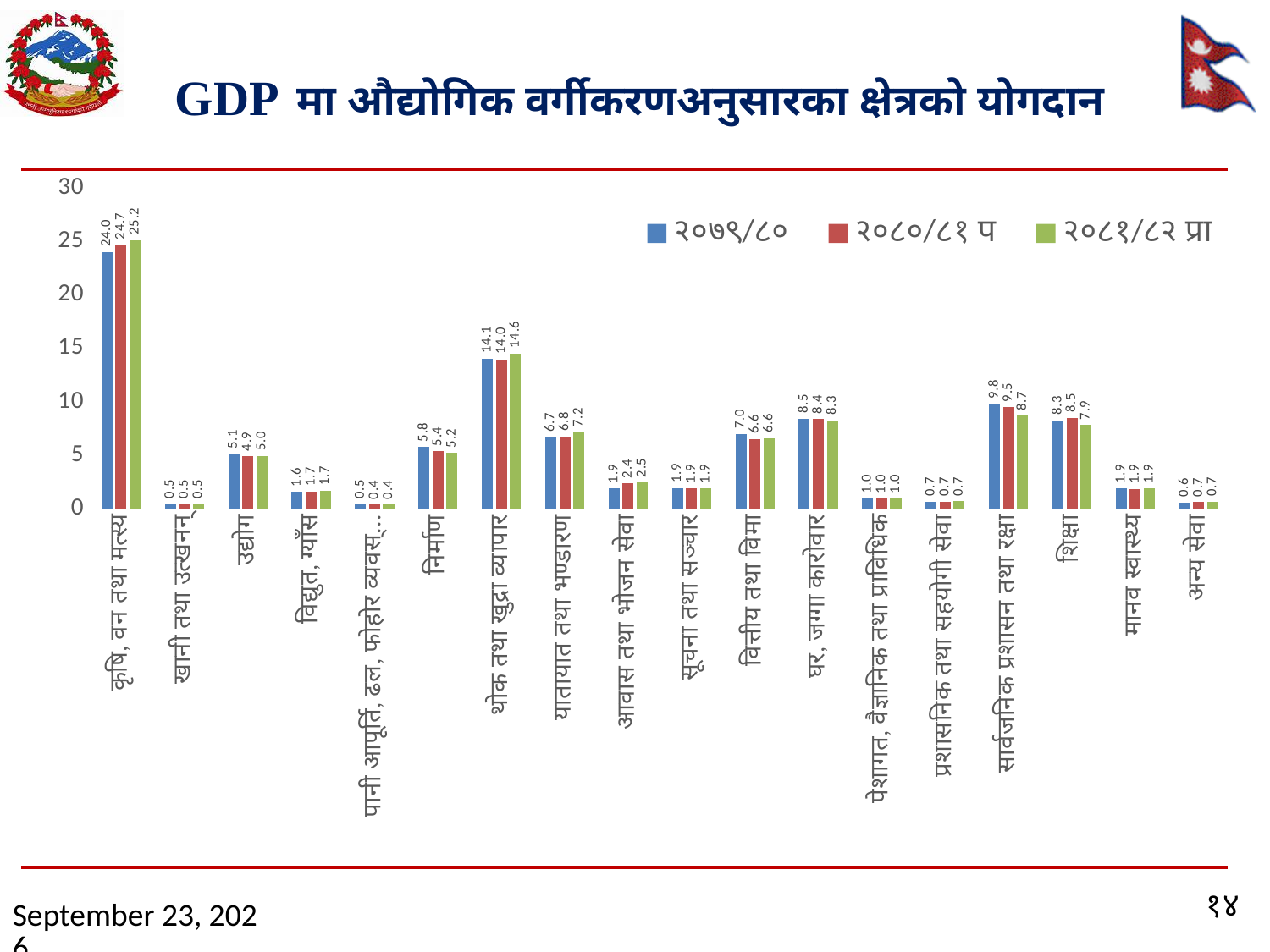
How many series does the legend list? 3 Which is larger in the २०८१/८२ प्रा series: यातायात तथा भण्डारण or निर्माण? यातायात तथा भण्डारण What is the difference between the २०८१/८२ प्रा and २०७९/८० values for कृषि, वन तथा मत्स्य? 1.2 What is the value for थोक तथा खुद्रा व्यापार in the २०७९/८० series? 14.1 What kind of chart is shown on the slide? bar chart Do the values for सार्वजनिक प्रशासन तथा रक्षा rise or fall across the three series from २०७९/८० to २०८१/८२ प्रा? fall How many categories are shown on the x axis? 18 What is the value for कृषि, वन तथा मत्स्य in the २०८१/८२ प्रा series? 25.2 Do the values for आवास तथा भोजन सेवा rise or fall across the three series from २०७९/८० to २०८१/८२ प्रा? rise What is the value for सार्वजनिक प्रशासन तथा रक्षा in the २०८०/८१ प series? 9.5 What colour are the bars for the २०८१/८२ प्रा series? green Which category has the highest value in the २०७९/८० series? कृषि, वन तथा मत्स्य